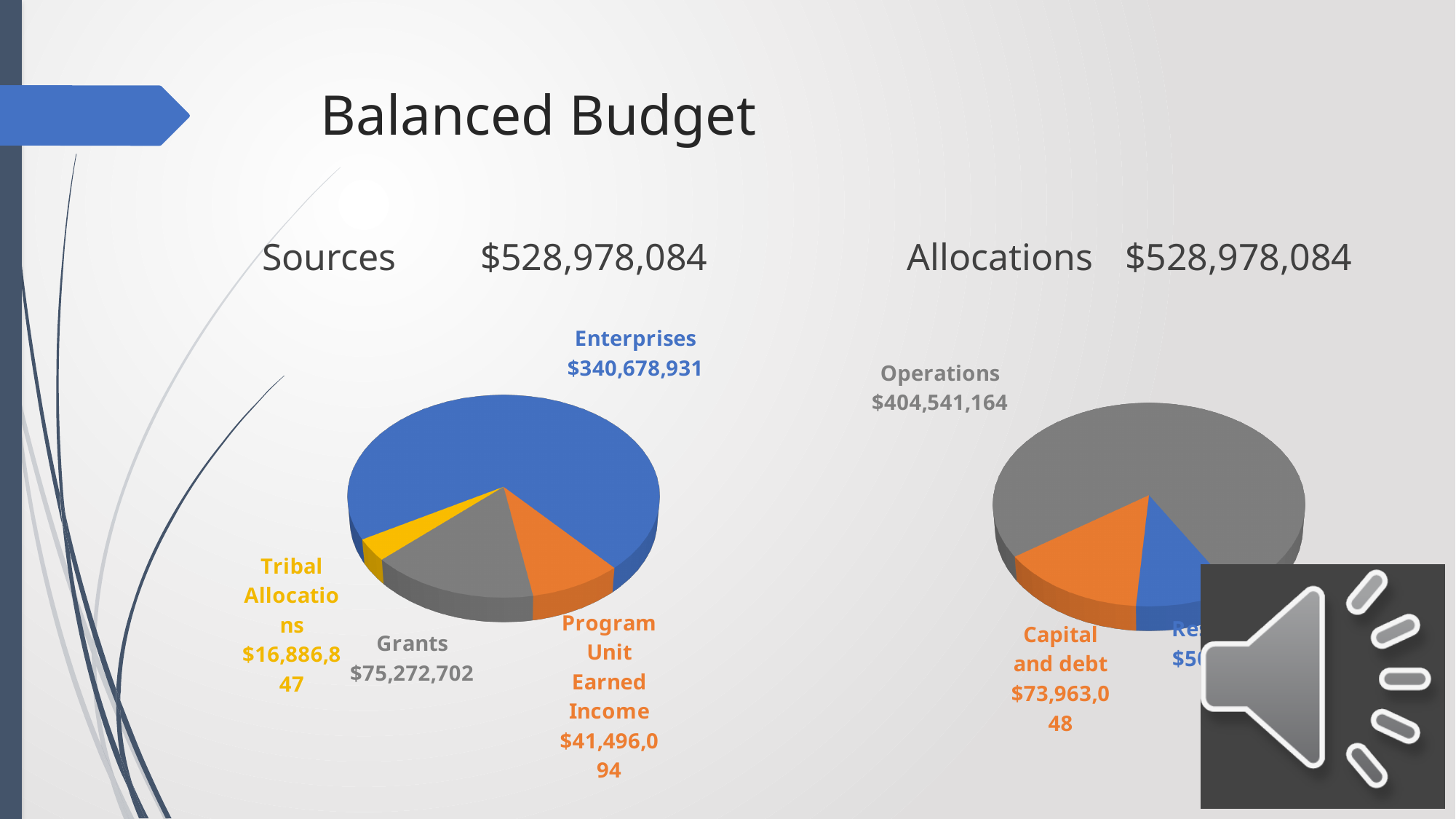
On the Sources chart, how many categories are shown? 4 On the Allocations chart, what is the value for Capital and debt? $73,963,048 On the Sources chart, which category has the smallest slice? Tribal Allocations What kind of chart is the Sources chart? Pie chart On the Sources chart, what is the value for Grants? $75,272,702 On the Allocations chart, which category has the largest slice? Operations On the Sources chart, what is the value for Program Unit Earned Income? $41,496,094 On the Sources chart, what is the difference between Grants and Program Unit Earned Income? $33,776,608 On the Sources chart, which category has the largest slice? Enterprises On the Sources chart, what is the value for Enterprises? $340,678,931 On the Allocations chart, what is the value for Operations? $404,541,164 On the Sources chart, what is the value for Tribal Allocations? $16,886,847